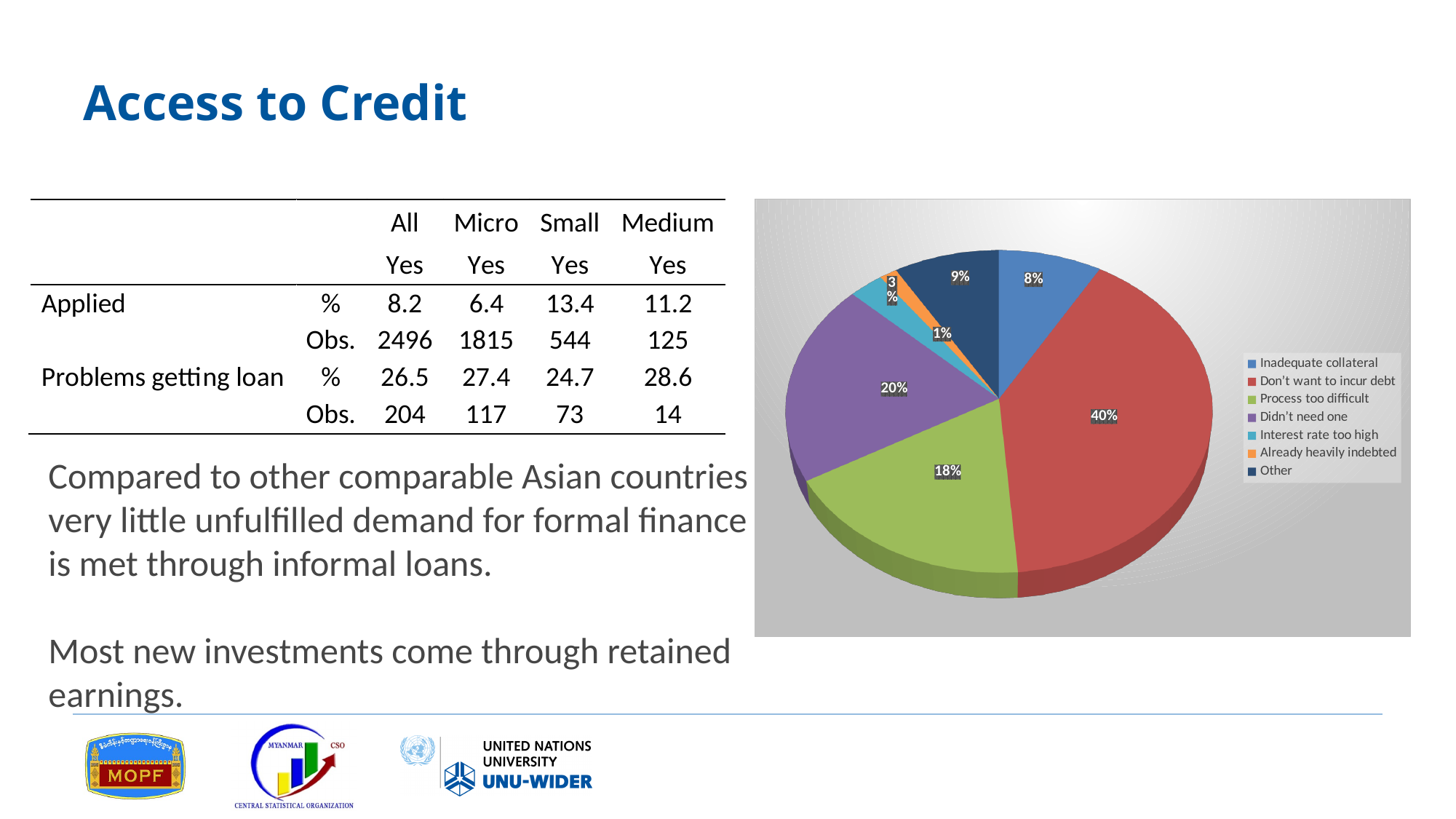
How many categories does the pie chart's legend list? 7 In the pie chart, what is the difference between the 'Don't want to incur debt' share and the 'Didn't need one' share? 20% Which category has the smallest slice in the pie chart? Already heavily indebted In the pie chart, what share is labelled for 'Already heavily indebted'? 1% In the pie chart, what share is labelled for 'Inadequate collateral'? 8% What kind of chart is shown on the right of the slide? pie chart Which category has the largest slice in the pie chart? Don't want to incur debt In the pie chart, what share is labelled for 'Didn't need one'? 20% In the pie chart, what share is labelled for 'Other'? 9% In the pie chart, what share is labelled for 'Don't want to incur debt'? 40% In the pie chart, what share is labelled for 'Process too difficult'? 18% In the pie chart, which slice is larger: 'Didn't need one' or 'Process too difficult'? Didn't need one